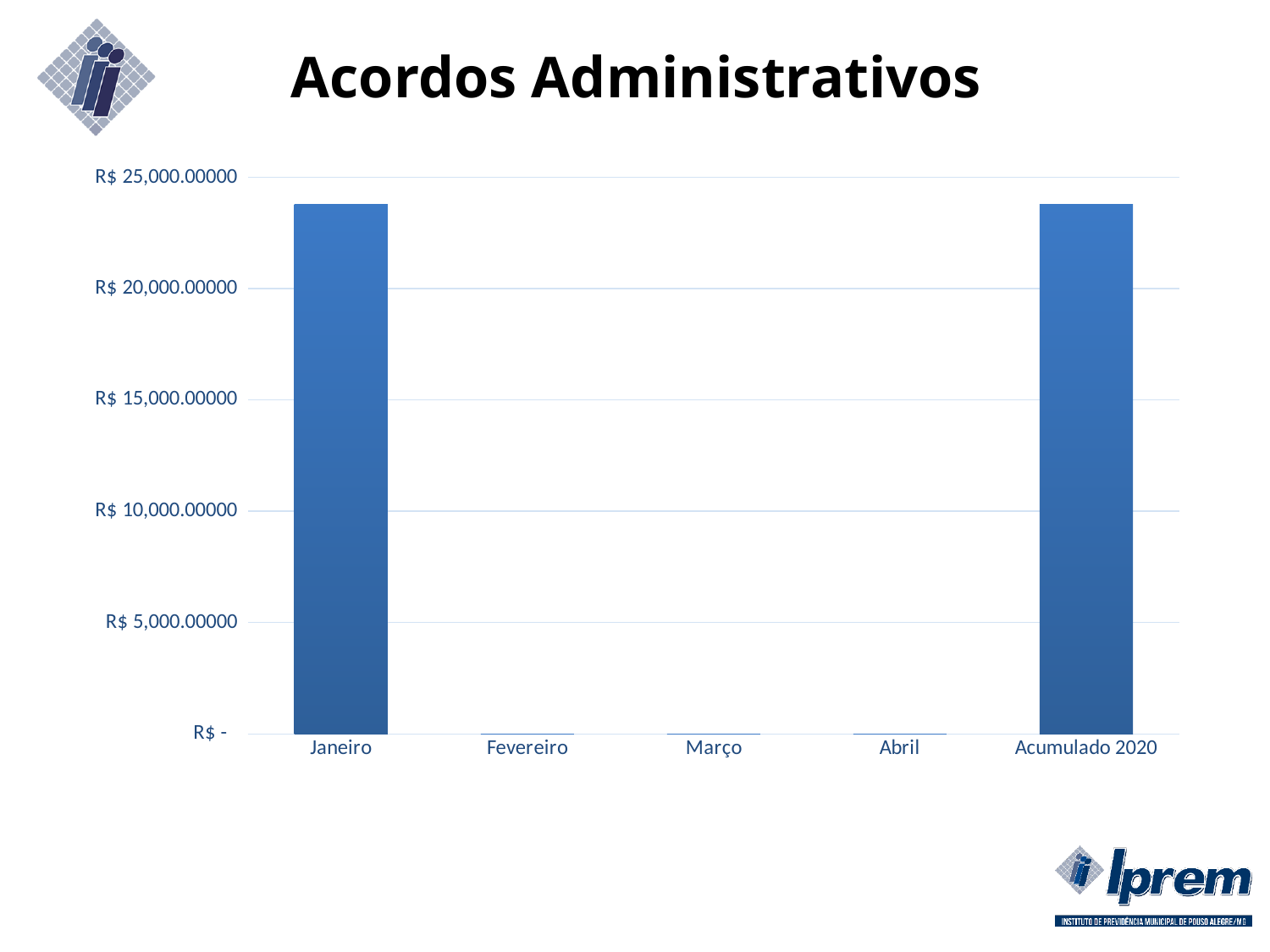
Is the value for Janeiro greater or less than R$ 20,000.00000? greater What is the title of the chart? Acordos Administrativos Which is larger, the value for Acumulado 2020 or the value for Abril? Acumulado 2020 Is the value for Janeiro greater or less than R$ 25,000.00000? less How many categories are shown on the x axis? 5 Is the value for Fevereiro greater or less than R$ 5,000.00000? less What kind of chart is shown on the slide? bar chart What is the label of the last category on the x axis? Acumulado 2020 Which is larger, the value for Janeiro or the value for Fevereiro? Janeiro What is the highest value shown on the y axis? R$ 25,000.00000 Do the values rise or fall from Janeiro to Fevereiro? fall